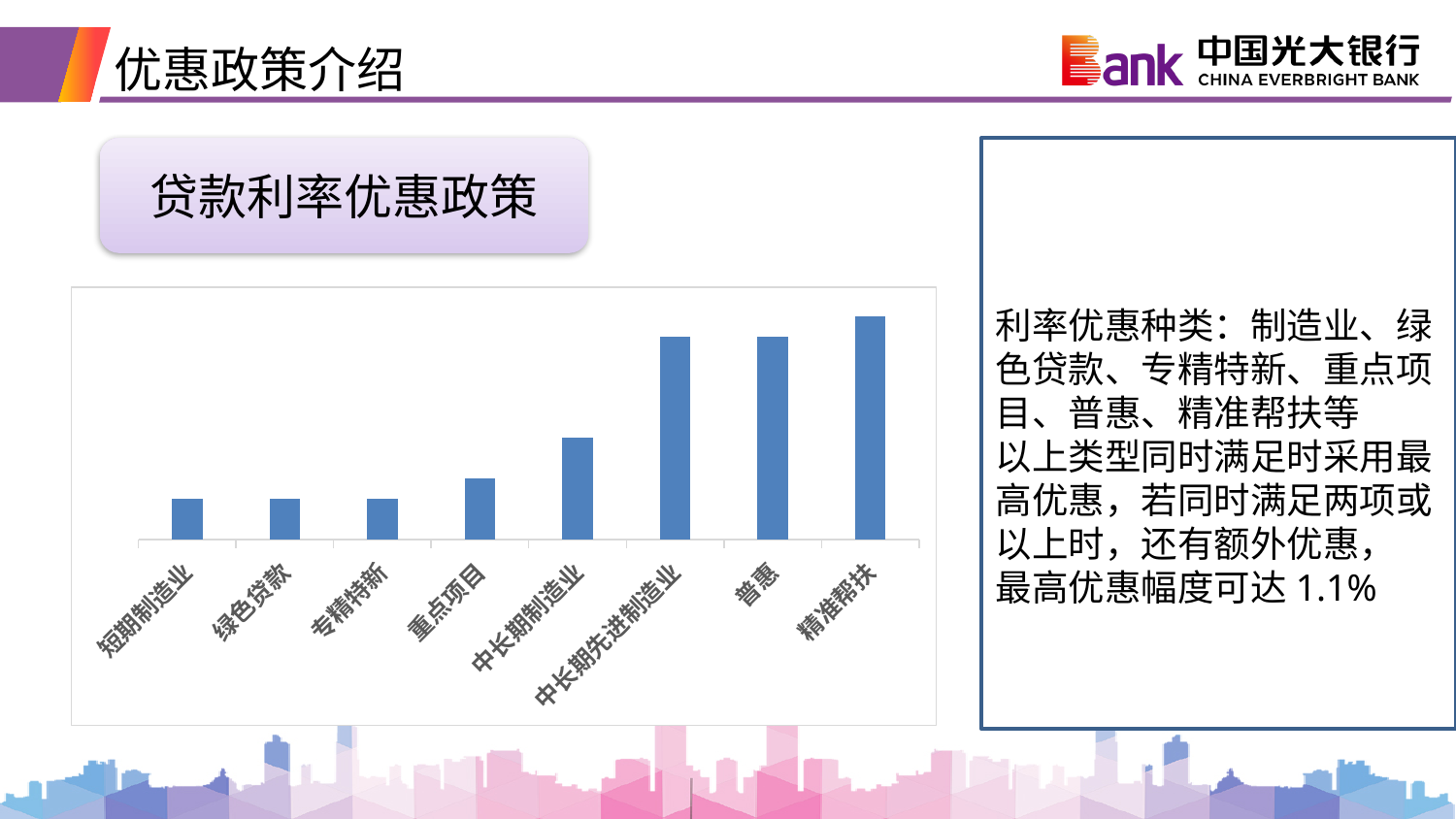
What kind of chart is shown on the slide? bar chart Which is larger, the bar for 中长期制造业 or the bar for 重点项目? 中长期制造业 How many categories are plotted in the bar chart? 8 Which is larger, the bar for 中长期先进制造业 or the bar for 专精特新? 中长期先进制造业 Which category has the highest bar in the chart? 精准帮扶 Which is larger, the bar for 精准帮扶 or the bar for 短期制造业? 精准帮扶 What colour are the bars in the chart? blue What is the label of the first category on the left of the x axis? 短期制造业 Do the bar values generally rise or fall from left to right along the x axis? rise